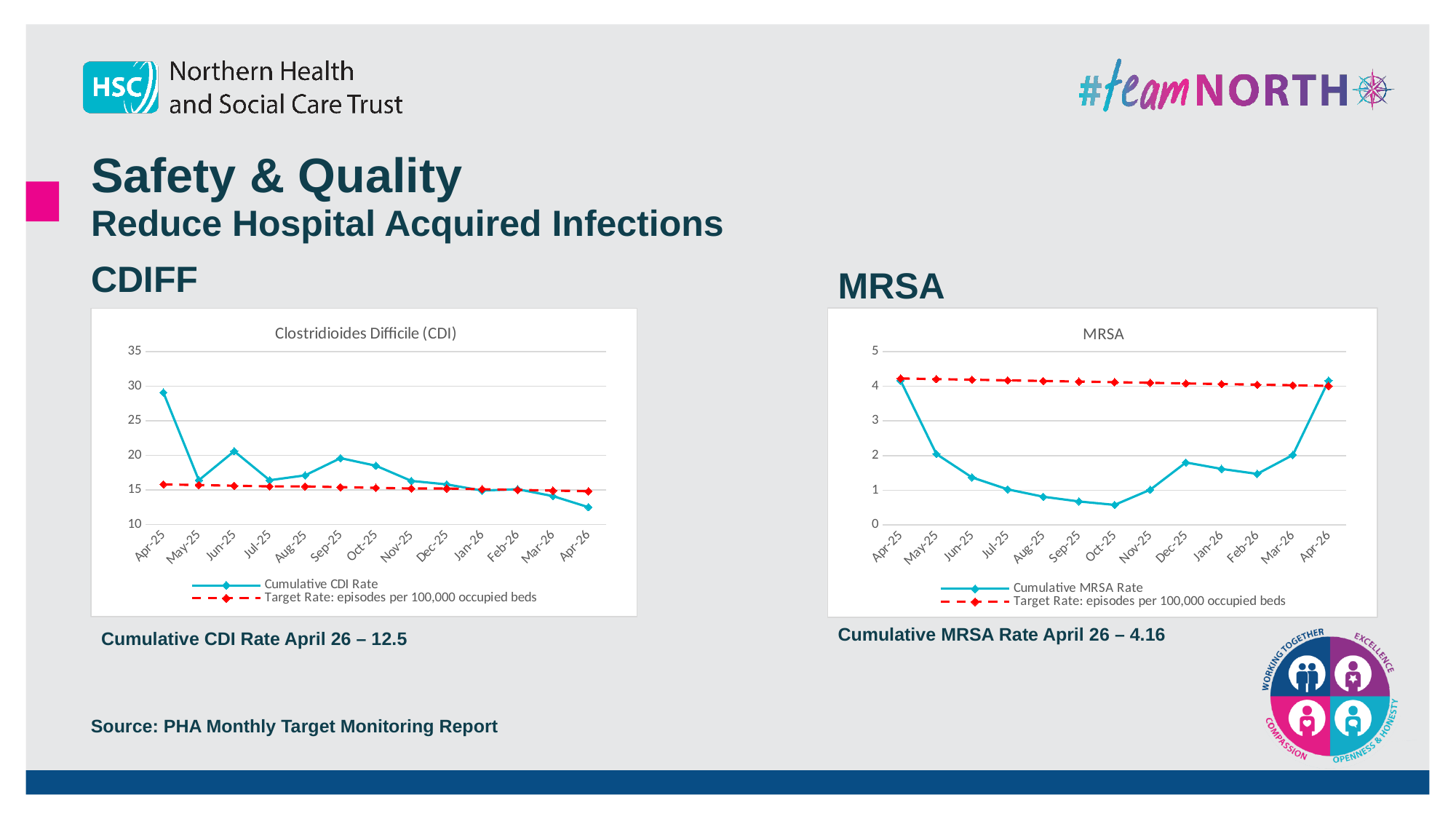
On the Clostridioides Difficile (CDI) chart, is the Cumulative CDI Rate for Apr-25 greater or less than 25? greater On the Clostridioides Difficile (CDI) chart, how many months are plotted along the x axis? 13 On the Clostridioides Difficile (CDI) chart, which month has the lowest Cumulative CDI Rate? Apr-26 On the MRSA chart, what is the name of the dashed red series in the legend? Target Rate: episodes per 100,000 occupied beds On the MRSA chart, what is the Cumulative MRSA Rate for Apr-26? 4.16 On the Clostridioides Difficile (CDI) chart, does the Cumulative CDI Rate generally rise or fall from Apr-25 to Apr-26? Fall On the MRSA chart, is the Cumulative MRSA Rate for Oct-25 greater or less than 1? less On the MRSA chart, which is larger, the Cumulative MRSA Rate for Dec-25 or for Jul-25? Dec-25 On the Clostridioides Difficile (CDI) chart, what is the Cumulative CDI Rate for Apr-26? 12.5 On the Clostridioides Difficile (CDI) chart, which month has the highest Cumulative CDI Rate? Apr-25 What kind of chart is the MRSA chart? Line chart On the MRSA chart, how many series does the legend list? 2